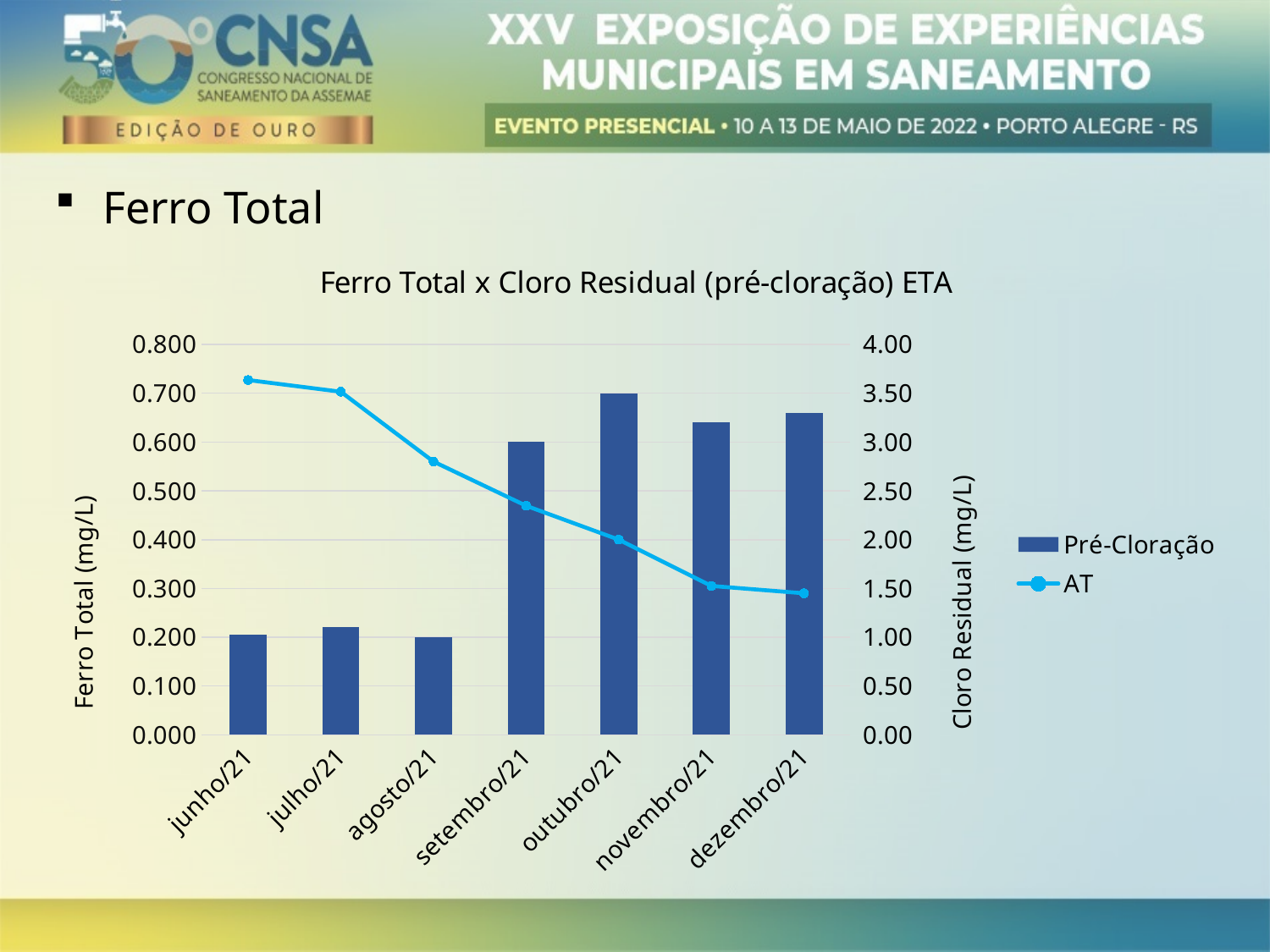
What kind of chart is shown on the slide? Combined bar and line chart Does the AT line rise or fall from junho/21 to dezembro/21? Fall Which is larger, the Pré-Cloração bar for setembro/21 or for julho/21? setembro/21 How many months are shown on the x axis? 7 Which month has the highest Pré-Cloração bar? outubro/21 What is the title of the chart? Ferro Total x Cloro Residual (pré-cloração) ETA How many series does the legend list? 2 Is the AT value for novembro/21 greater or less than 2.00? less Which month has the highest AT value? junho/21 Is the Pré-Cloração value for dezembro/21 greater or less than 0.600? greater